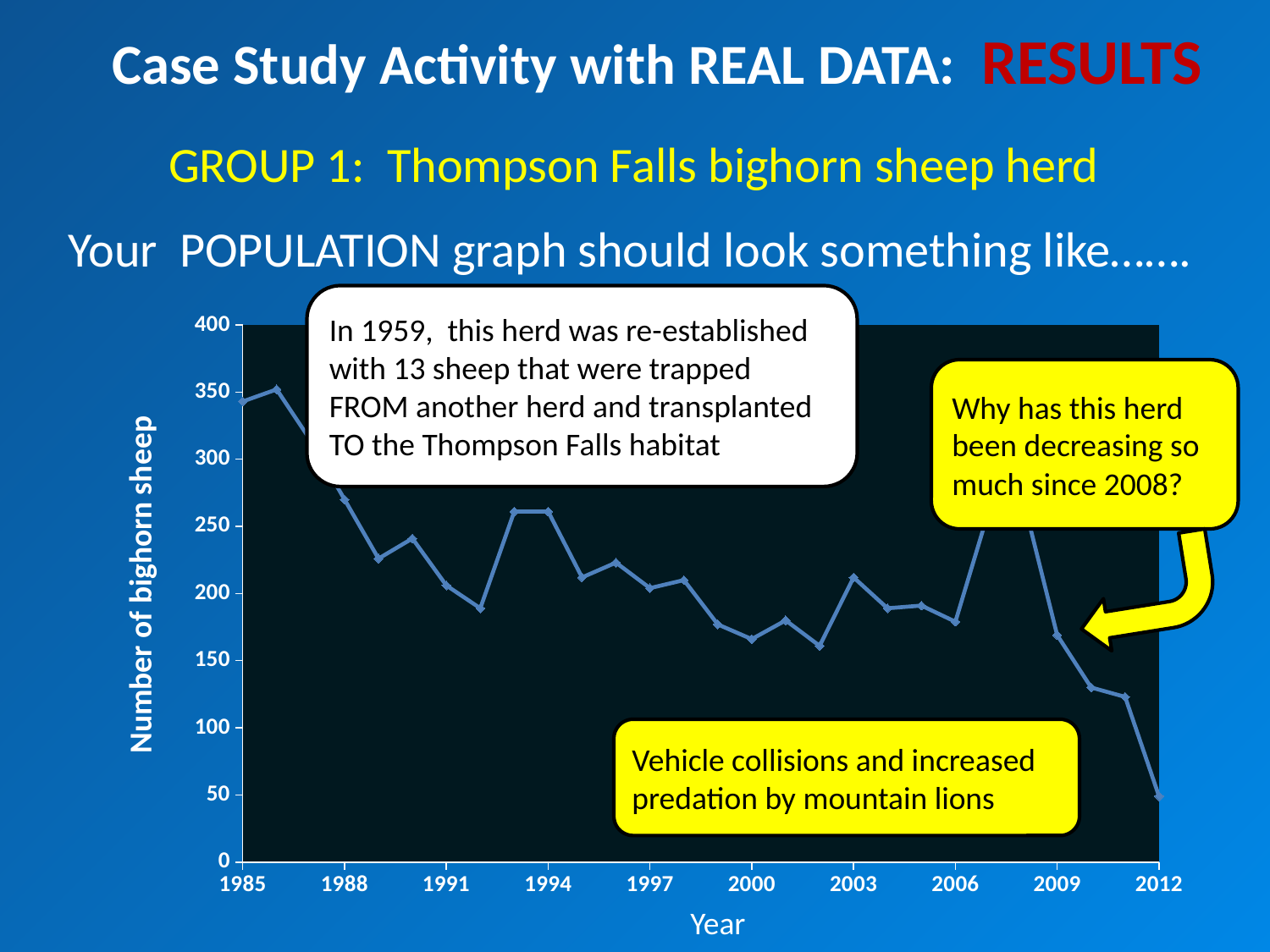
Is the value for 2011 greater or less than 100? greater Is the value for 1992 greater or less than 200? less Overall, do the values rise or fall from 1985 to 2012? fall Is the value for 1985 greater or less than 300? greater What kind of chart is shown on the slide? line chart Which year has the lowest number of bighorn sheep? 2012 Which is larger, the value for 1985 or the value for 2012? 1985 What is the label of the vertical axis? Number of bighorn sheep What is the label of the horizontal axis? Year